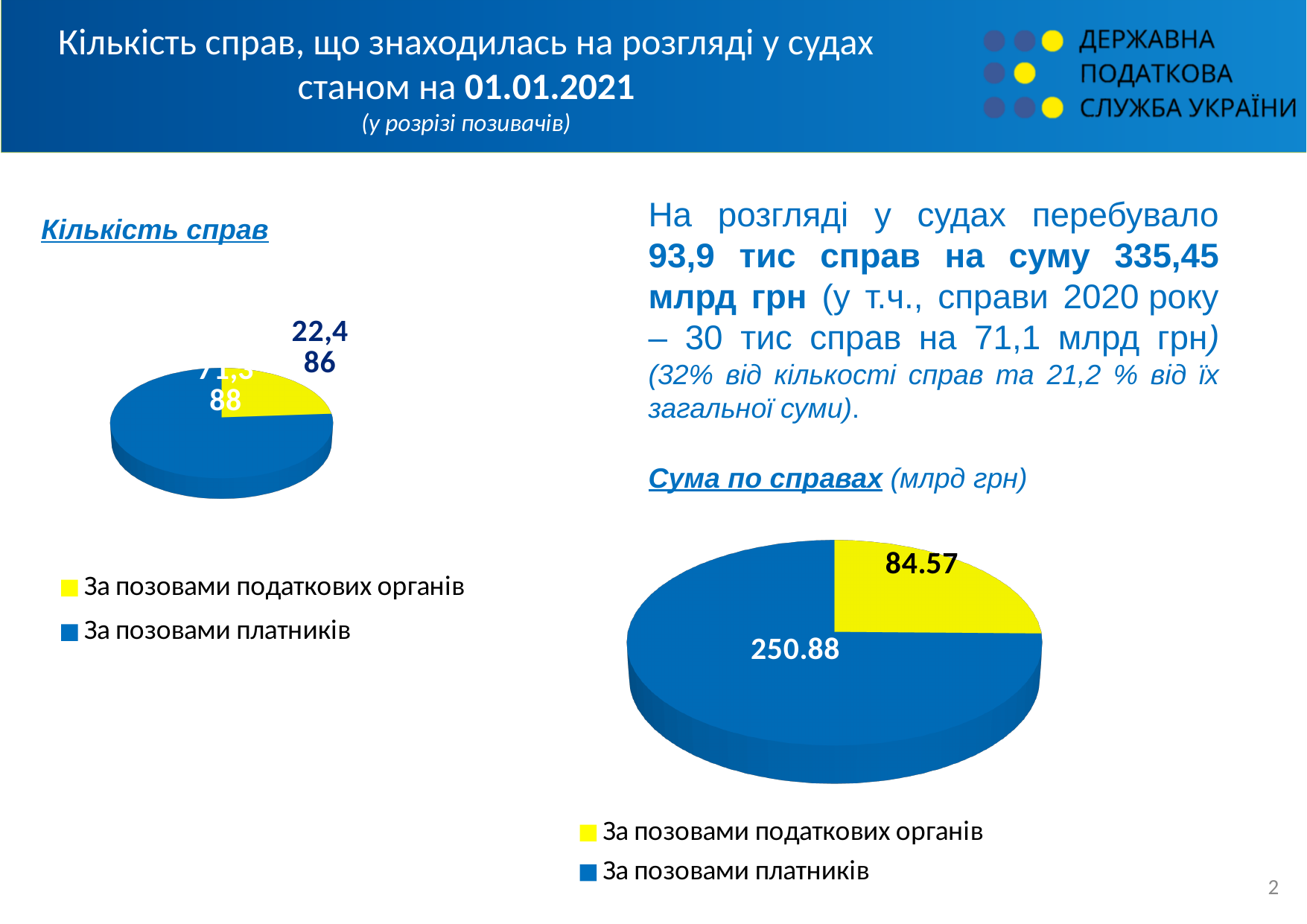
In the 'Сума по справах' chart, which category has the smallest slice? За позовами податкових органів In the 'Сума по справах' chart, what is the difference between 'За позовами платників' and 'За позовами податкових органів'? 166.31 In the 'Кількість справ' chart, what is the value for 'За позовами податкових органів'? 22,486 In the 'Сума по справах' chart, which category has the largest slice? За позовами платників In the 'Сума по справах' chart, what is the total of the two slices? 335.45 In the 'Сума по справах' chart, what colour represents 'За позовами податкових органів'? Yellow How many categories does the 'Кількість справ' chart show? 2 In the 'Сума по справах' chart, what is the value for 'За позовами платників'? 250.88 In the 'Сума по справах' chart, which is larger: 'За позовами платників' or 'За позовами податкових органів'? За позовами платників In the 'Кількість справ' chart, which category has the largest slice? За позовами платників In the 'Сума по справах' chart, what is the value for 'За позовами податкових органів'? 84.57 What kind of chart is the 'Кількість справ' chart? Pie chart